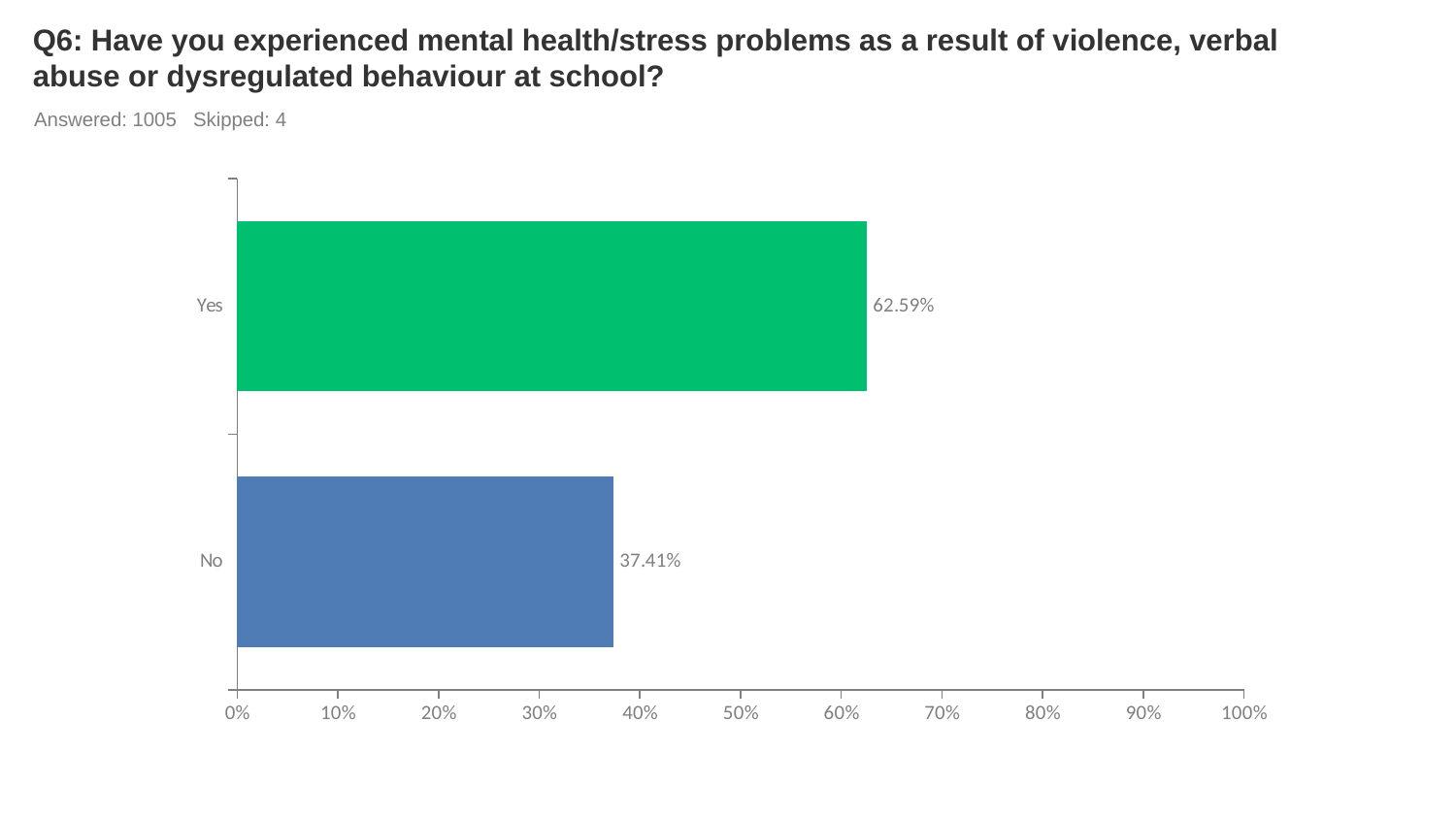
How many response categories are shown in the chart? 2 What colour is the bar for the Yes response? Green Which response is larger, Yes or No? Yes What kind of chart is shown on the slide? Bar chart What percentage of respondents answered Yes? 62.59% Is the value for No greater or less than 40%? less How many respondents answered the question? 1005 Which response has the lowest percentage? No What is the difference in percentage points between the Yes and No responses? 25.18 Is the value for Yes greater or less than 60%? greater What percentage of respondents answered No? 37.41% Which response has the highest percentage? Yes